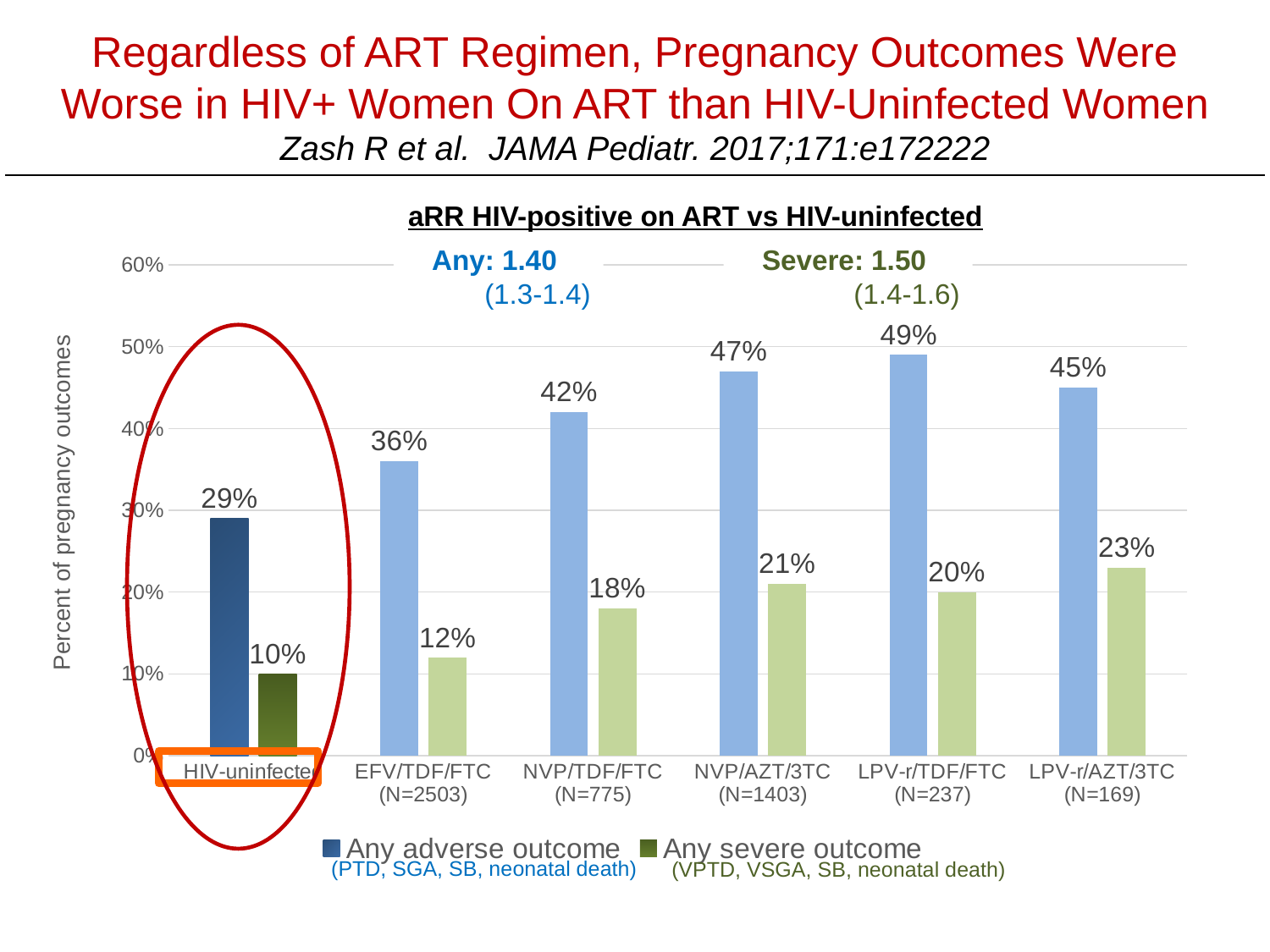
What kind of chart is shown on the slide? Bar chart What is the value of 'Any severe outcome' for the LPV-r/AZT/3TC (N=169) group? 23% Which group has the lowest value for 'Any severe outcome'? HIV-uninfected What is the value of 'Any adverse outcome' for the HIV-uninfected group? 29% Which is larger: the 'Any severe outcome' value for NVP/AZT/3TC (N=1403) or for LPV-r/TDF/FTC (N=237)? NVP/AZT/3TC (N=1403) What is the value of 'Any adverse outcome' for the NVP/TDF/FTC (N=775) group? 42% What is the difference between the 'Any adverse outcome' values for EFV/TDF/FTC (N=2503) and HIV-uninfected? 7% What is the label of the y axis? Percent of pregnancy outcomes How many series does the legend list? 2 What is the adjusted relative risk (aRR) for any adverse outcome in HIV-positive women on ART vs HIV-uninfected women? 1.40 Which group has the highest value for 'Any adverse outcome'? LPV-r/TDF/FTC (N=237) How many groups are shown on the x axis? 6